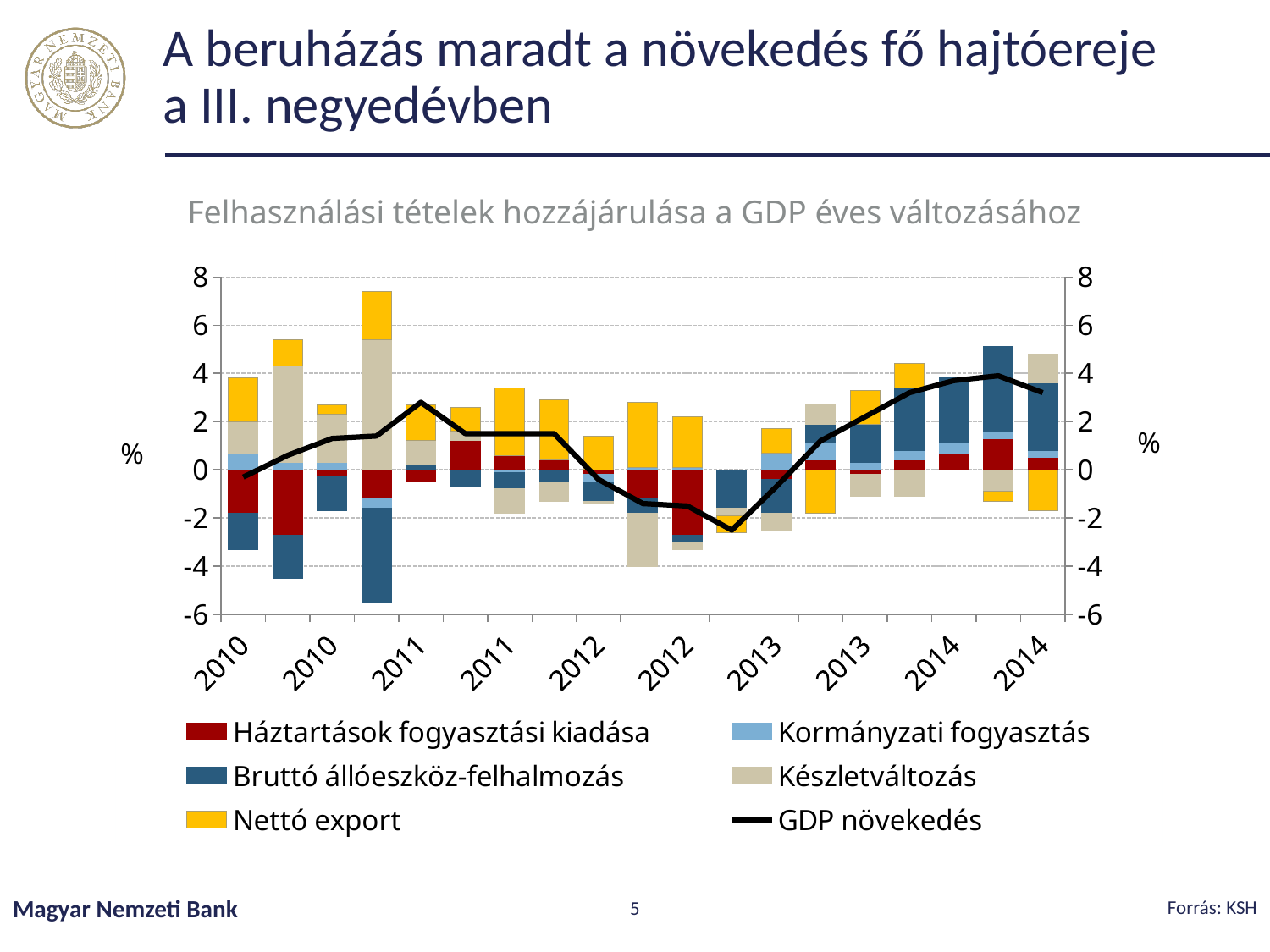
How many stacked bars are plotted in the chart? 19 Is the lowest point of the GDP növekedés line (in 2013) greater or less than -2? less What is the title of the chart? Felhasználási tételek hozzájárulása a GDP éves változásához Is the value of the GDP növekedés line at the first point (2010) greater or less than 0? less Does the GDP növekedés line rise or fall between the 2013 labels and the 2014 labels? rise Which is larger: the GDP növekedés value at the last 2014 point or at the first 2010 point? the last 2014 point Is the value of the GDP növekedés line at the last point (2014) greater or less than 2? greater Which series is drawn as a black line rather than as bars? GDP növekedés How many series does the legend list? 6 What kind of chart is shown on the slide? Stacked bar chart with a line Does the GDP növekedés line rise or fall between the first 2012 label and the first 2013 label? fall